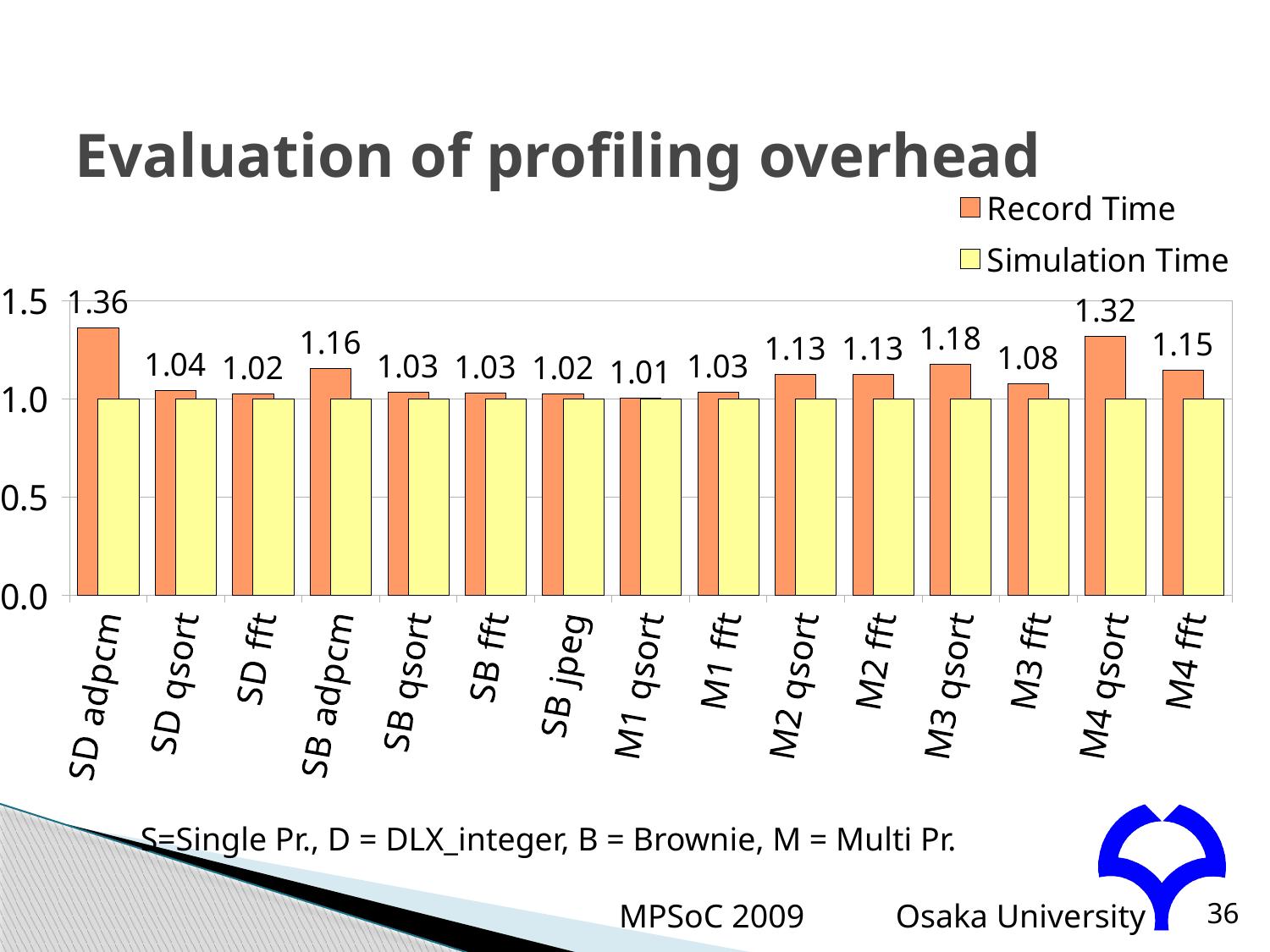
What is the Record Time value for M3 qsort? 1.18 What is the Record Time value for M1 qsort? 1.01 What is the Record Time value for M4 qsort? 1.32 Which has a larger Record Time, SB adpcm or M3 fft? SB adpcm How many categories are shown on the x axis? 15 How many series does the legend list? 2 What is the difference between the Record Time for SD adpcm and for M4 qsort? 0.04 What kind of chart is shown on the slide? bar chart Which category has the highest Record Time? SD adpcm Is the Record Time for M4 qsort greater or less than 1.5? less Which category has the lowest Record Time? M1 qsort What is the Record Time value for SD adpcm? 1.36